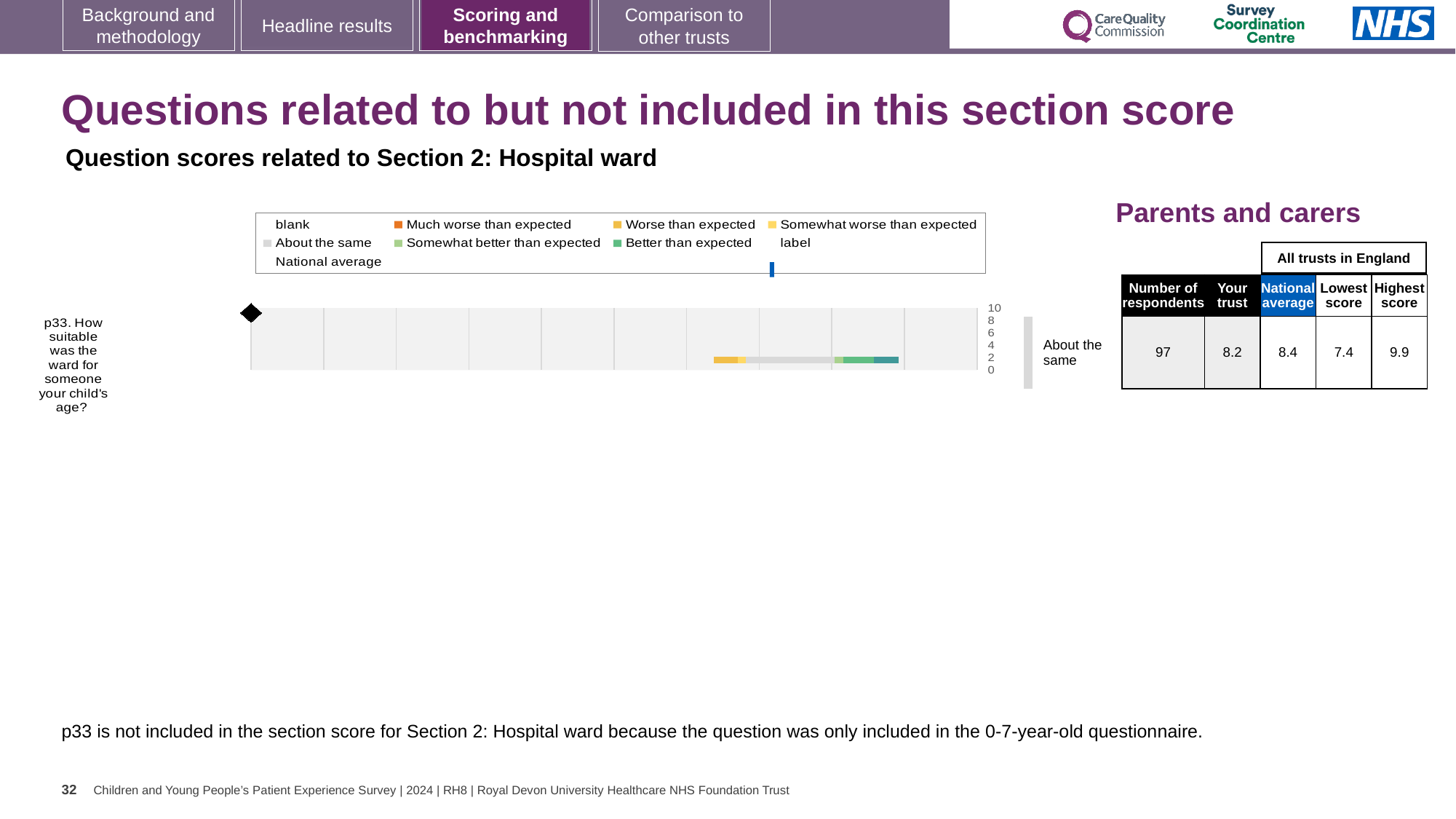
In the table beside the chart, how many respondents answered p33? 97 In the table beside the chart, what is the national average score for p33? 8.4 What is the label of the question plotted in the chart? p33. How suitable was the ward for someone your child's age? In the table beside the chart, what is the highest score among all trusts in England for p33? 9.9 In the table beside the chart, what is the lowest score among all trusts in England for p33? 7.4 What is the highest tick value shown on the chart's axis? 10 What kind of chart is used to show the p33 score? bar chart What benchmarking category is shown to the right of the chart for p33? About the same How many survey questions are plotted in the chart? 1 What is the difference between the highest score and the lowest score for p33 in the table beside the chart? 2.5 In the table beside the chart, what is the 'Your trust' score for p33? 8.2 Which is larger for p33: the 'Your trust' score or the national average? National average